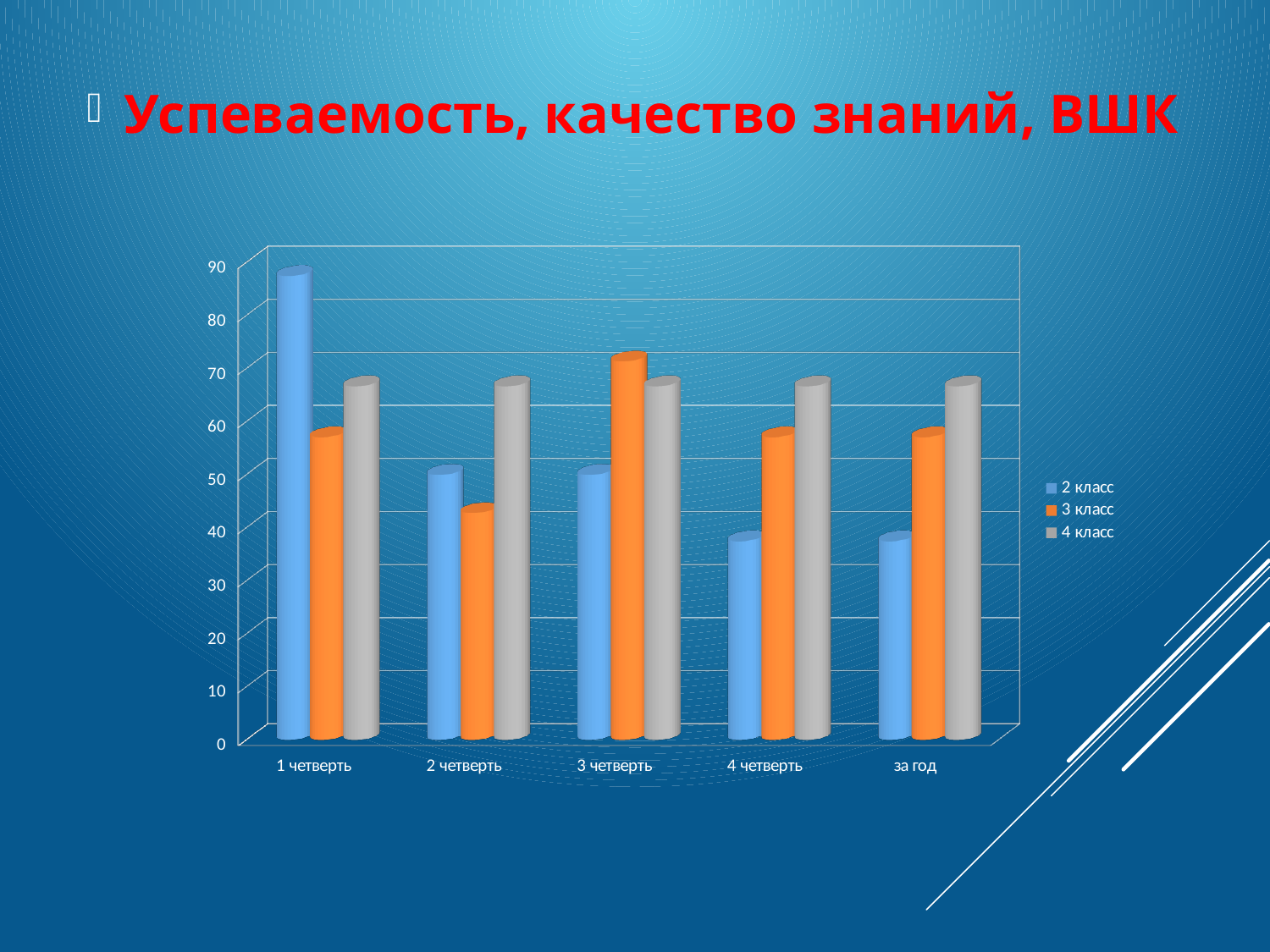
How many categories are shown on the x axis? 5 Is the value for 2 класс in 4 четверть greater or less than 50? less Is the value for 3 класс in 3 четверть greater or less than 60? greater In 2 четверть, which is larger: the value for 2 класс or for 4 класс? 4 класс In which category does 3 класс have its lowest value? 2 четверть How many series does the legend list? 3 Which series are listed in the legend? 2 класс, 3 класс, 4 класс Is the value for 2 класс in 1 четверть greater or less than 80? greater Which series has the highest value in 3 четверть? 3 класс In which category does 2 класс have its highest value? 1 четверть What kind of chart is shown on the slide? bar chart